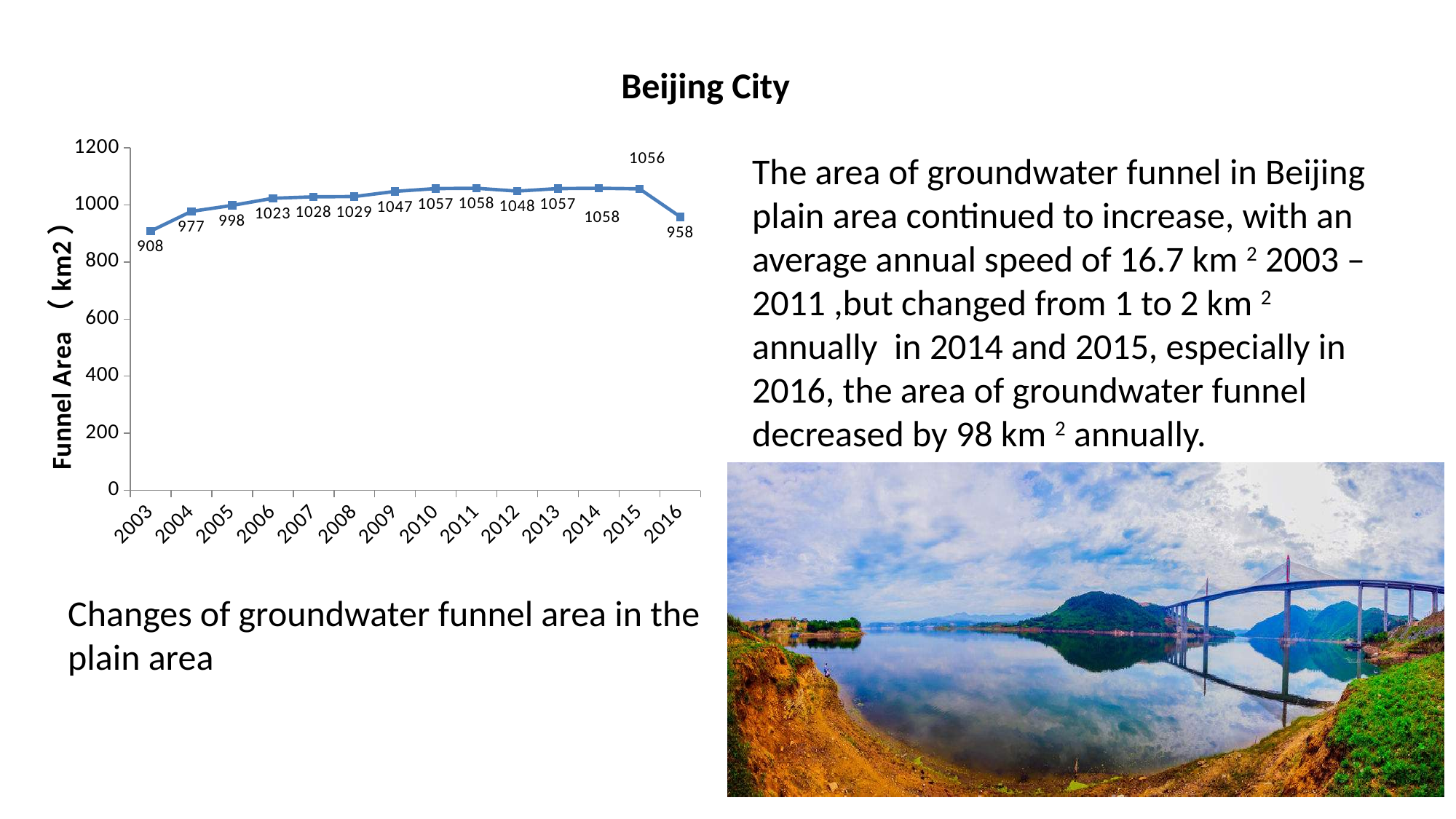
Which year has a larger funnel area, 2005 or 2012? 2012 What is the difference between the funnel area in 2004 and in 2003? 69 What was the funnel area in 2016? 958 What type of chart is shown on the slide? line chart What is the difference between the funnel area in 2015 and in 2016? 98 What is the label of the vertical axis? Funnel Area (km2) What was the funnel area in 2015? 1056 How many years are plotted on the chart? 14 Which year has the lowest funnel area? 2003 What was the funnel area in 2003? 908 What was the funnel area in 2009? 1047 Does the funnel area rise or fall from 2003 to 2011? rise